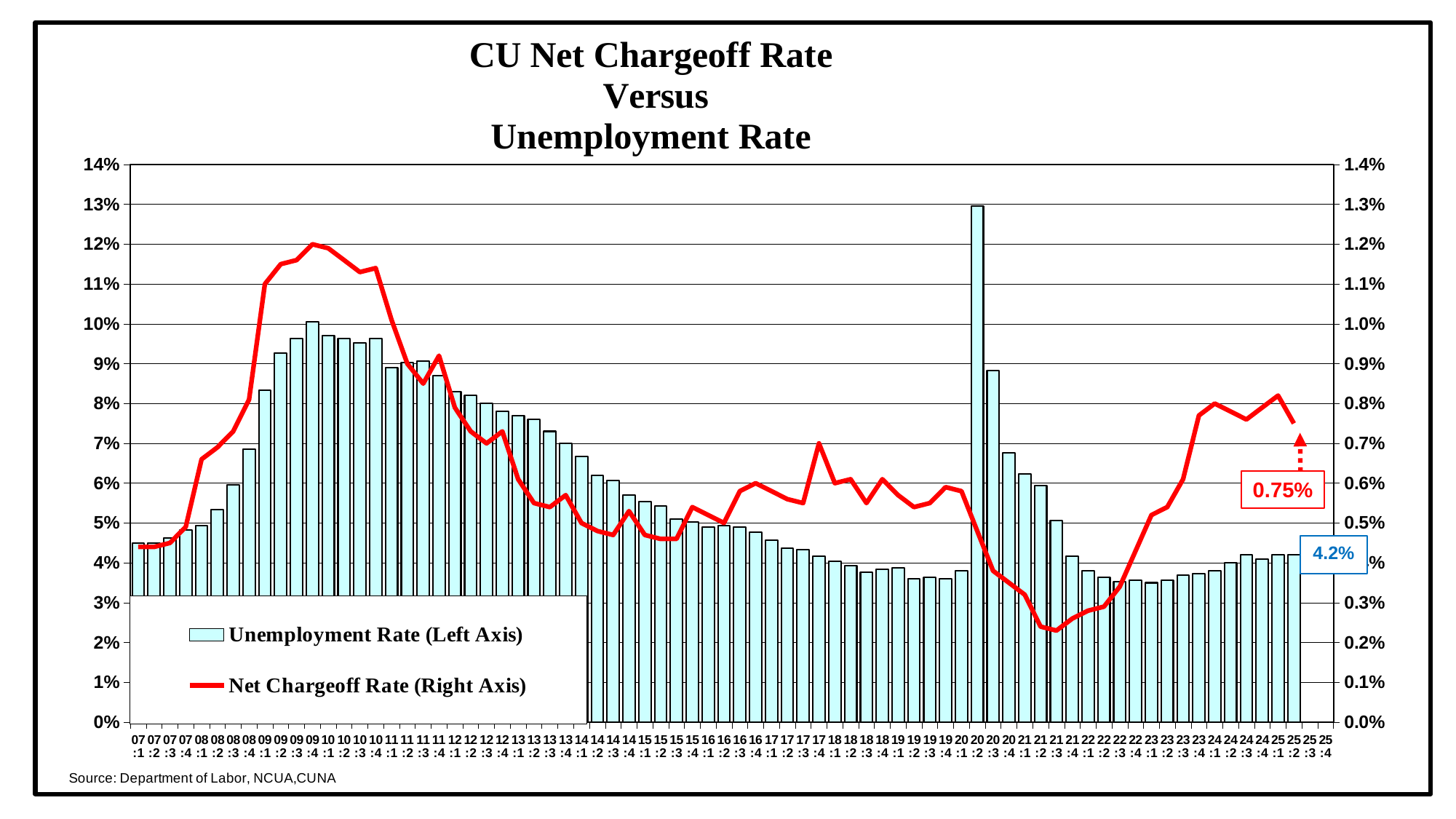
Is the Net Chargeoff Rate for 21:3 greater or less than 0.3%? less What is the labeled value of the most recent Net Chargeoff Rate data point? 0.75% Which series is plotted on the right axis according to the legend? Net Chargeoff Rate What is the labeled value of the most recent Unemployment Rate bar? 4.2% Which quarter has the highest Unemployment Rate bar? 20:2 Is the Net Chargeoff Rate for 09:4 greater or less than 1.1%? greater What is the title of the chart? CU Net Chargeoff Rate Versus Unemployment Rate How many series does the legend list? 2 What kind of chart is this? Combined bar and line chart Does the Unemployment Rate generally rise or fall from 10:1 to 19:4? fall Which quarter has the higher Unemployment Rate, 09:4 or 14:1? 09:4 Is the Unemployment Rate for 20:2 greater or less than 12%? greater